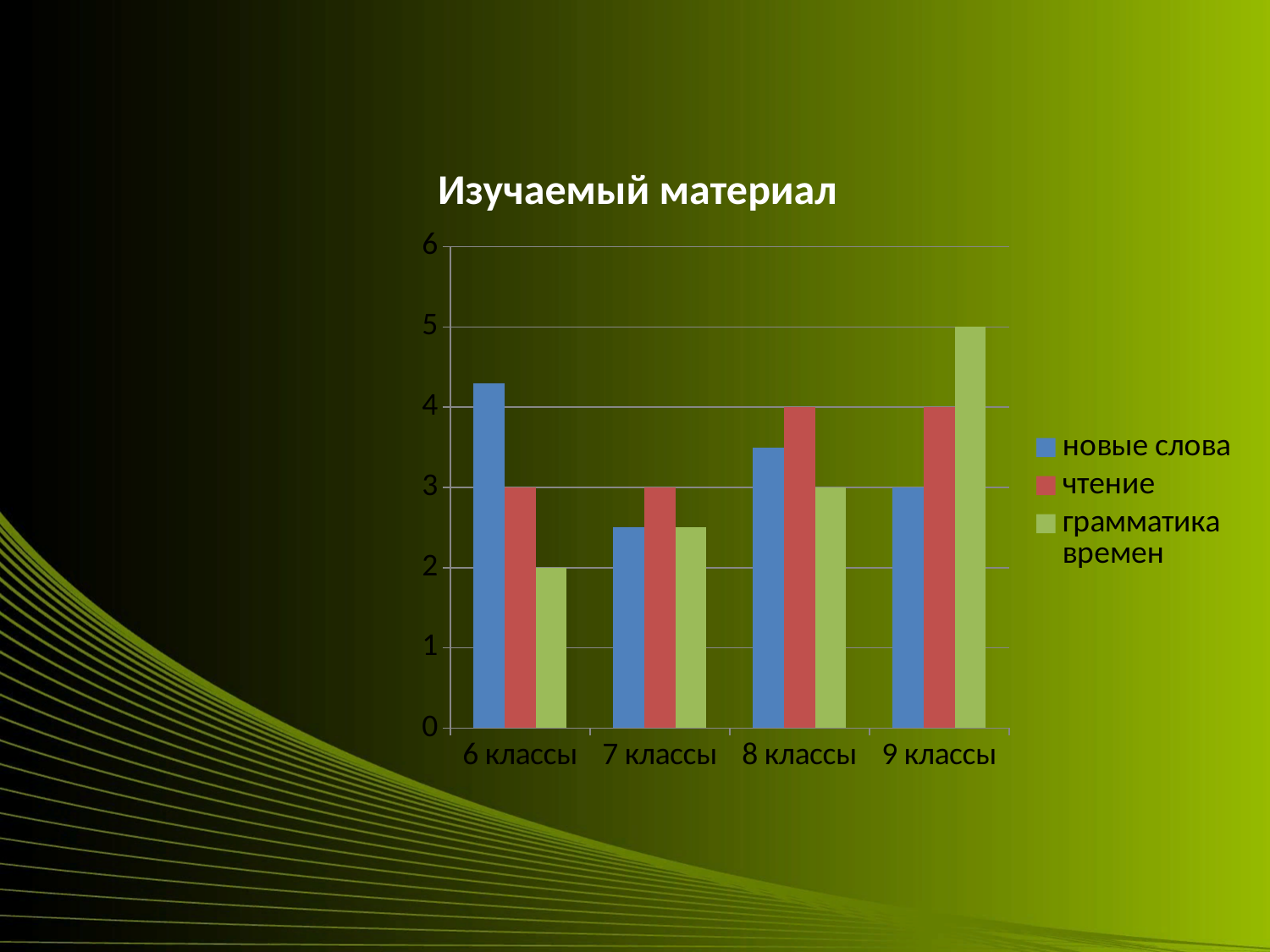
What kind of chart is shown on the slide? bar chart Is the value for новые слова in 6 классы greater or less than 4? greater What is the value for грамматика времен in 6 классы? 2 What is the value for грамматика времен in 9 классы? 5 Which category has the lowest value for новые слова? 7 классы What is the difference between the грамматика времен values for 9 классы and 6 классы? 3 Do the values for грамматика времен rise or fall from 6 классы to 9 классы? rise Which category has the highest value for грамматика времен? 9 классы How many series does the legend list? 3 What is the value for чтение in 8 классы? 4 How many categories are shown on the x axis? 4 What is the title of the chart? Изучаемый материал